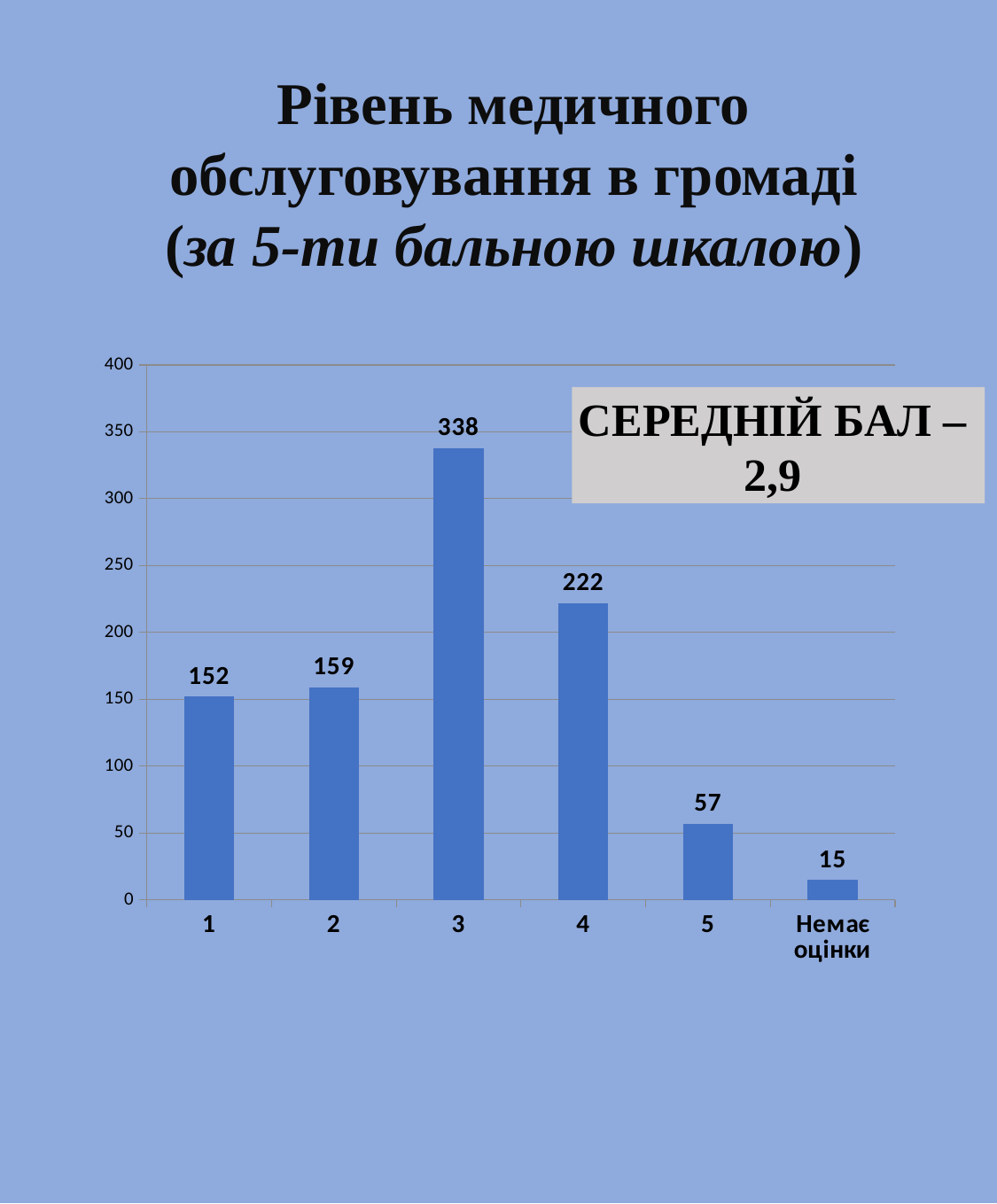
Which category has the lowest value? Немає оцінки What is the value for category 5? 57 What is the value for the 'Немає оцінки' category? 15 What kind of chart is shown on the slide? bar chart What is the value for category 3? 338 What is the difference between the values for category 2 and category 1? 7 What is the difference between the values for category 3 and category 4? 116 What average score (СЕРЕДНІЙ БАЛ) is stated on the slide? 2,9 Which category has the highest value? 3 How many categories are shown on the x axis? 6 Is the value for category 4 greater or less than 200? greater Which is larger, the value for category 4 or the value for category 2? 4